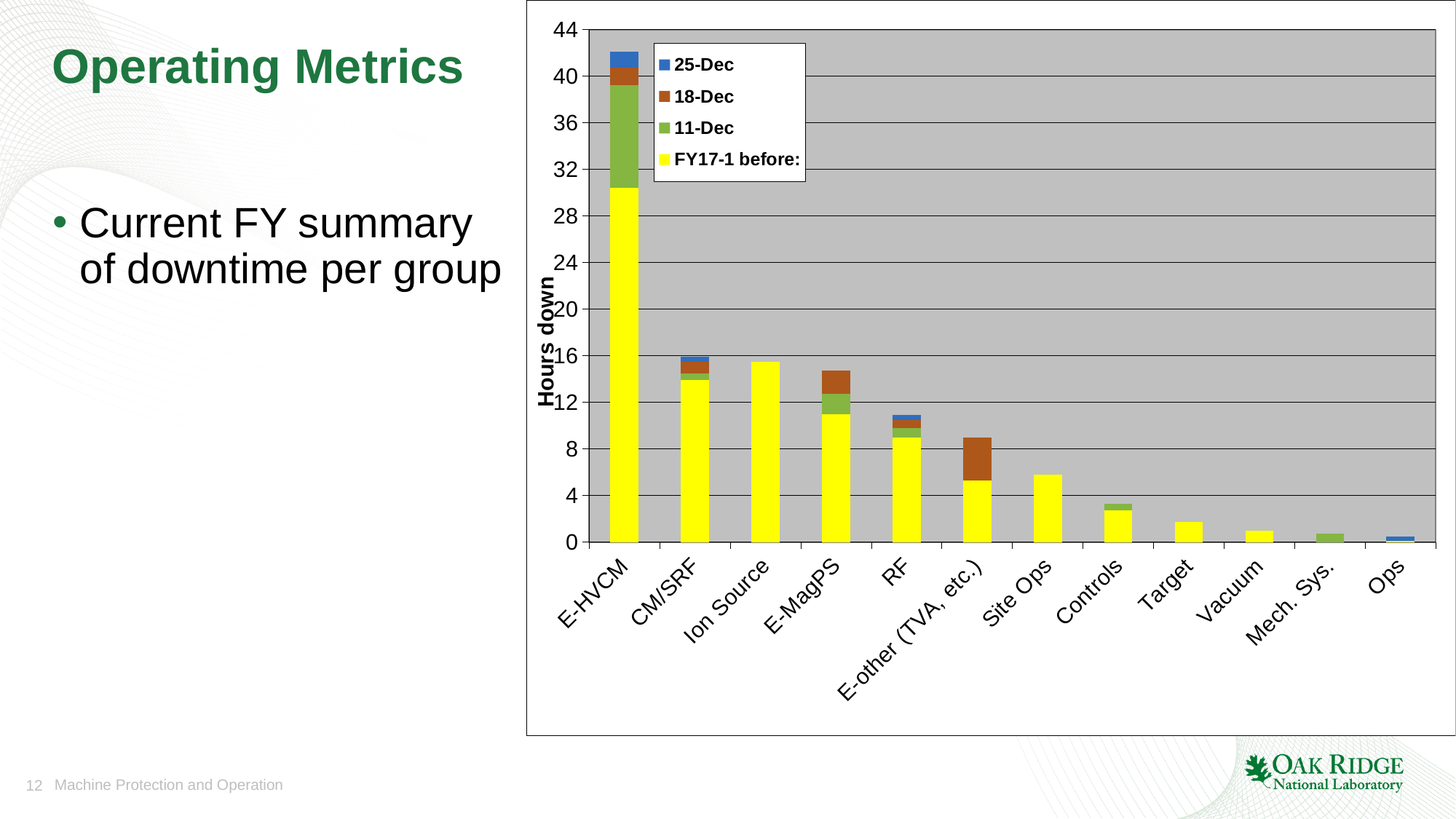
What kind of chart is shown on the slide? Stacked bar chart Which group has the lowest total hours down? Ops Is the total value for E-MagPS greater or less than 12? greater Do the total hours down generally rise or fall moving from left to right along the x axis? fall Is the total value for E-HVCM greater or less than 40? greater Is the total value for Controls greater or less than 4? less Which group has the highest total hours down? E-HVCM What is the label of the chart's vertical axis? Hours down Which has more total hours down, Ion Source or Site Ops? Ion Source How many series does the chart's legend list? 4 How many groups (categories) are shown on the x axis of the chart? 12